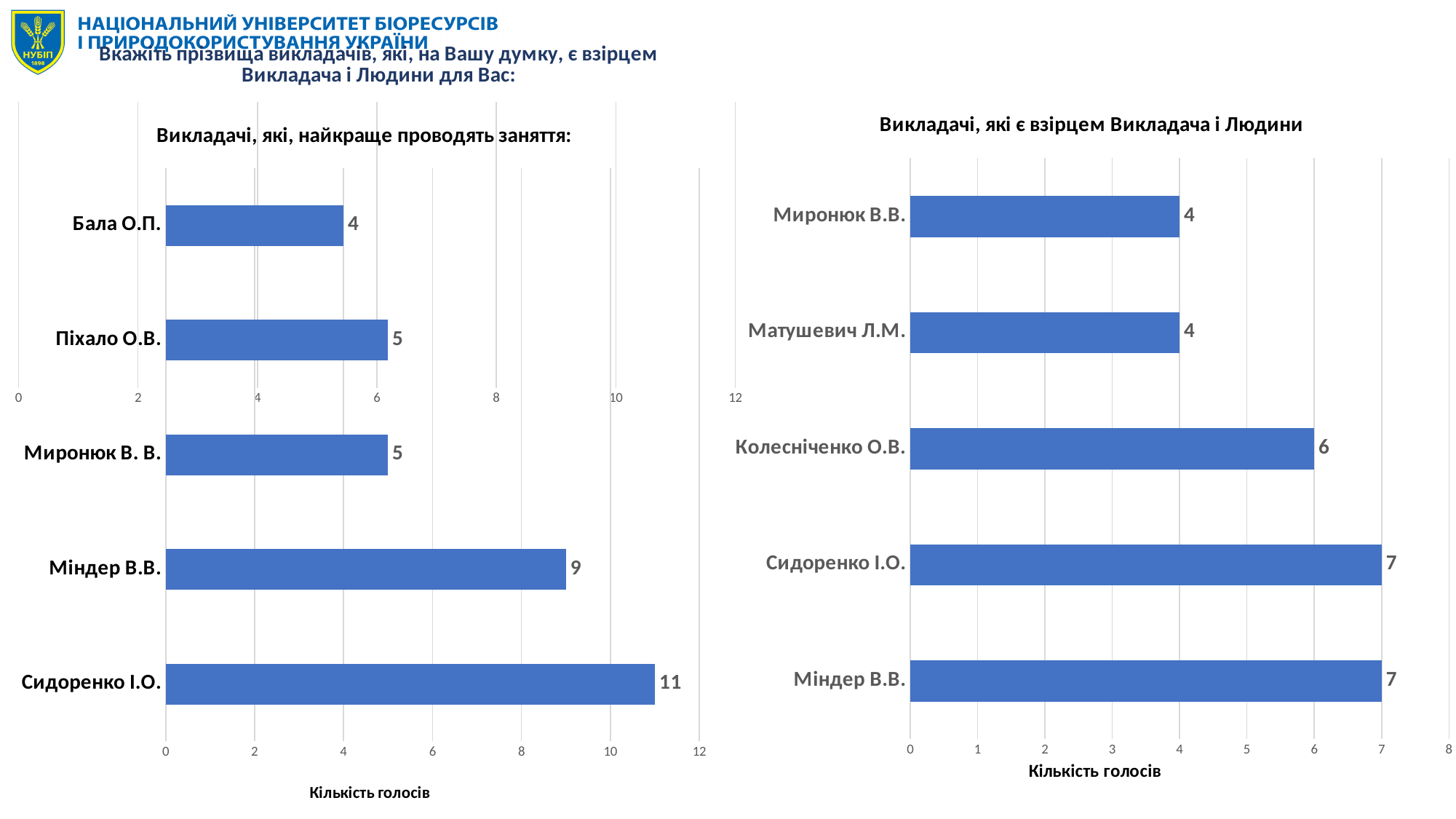
In the chart 'Викладачі, які, найкраще проводять заняття:', which teacher has the lowest number of votes? Бала О.П. In the chart 'Викладачі, які, найкраще проводять заняття:', how many teachers are listed? 5 In the chart 'Викладачі, які є взірцем Викладача і Людини', which has more votes, Колесніченко О.В. or Миронюк В.В.? Колесніченко О.В. In the chart 'Викладачі, які, найкраще проводять заняття:', which teacher has the highest number of votes? Сидоренко І.О. What type of chart is 'Викладачі, які є взірцем Викладача і Людини'? Bar chart In the chart 'Викладачі, які є взірцем Викладача і Людини', how many votes did Матушевич Л.М. receive? 4 What is the x-axis title of the chart 'Викладачі, які є взірцем Викладача і Людини'? Кількість голосів In the chart 'Викладачі, які є взірцем Викладача і Людини', what is the difference in votes between Сидоренко І.О. and Матушевич Л.М.? 3 In the chart 'Викладачі, які, найкраще проводять заняття:', what is the difference in votes between Сидоренко І.О. and Міндер В.В.? 2 In the chart 'Викладачі, які, найкраще проводять заняття:', how many votes did Міндер В.В. receive? 9 In the chart 'Викладачі, які є взірцем Викладача і Людини', how many votes did Колесніченко О.В. receive? 6 In the chart 'Викладачі, які, найкраще проводять заняття:', how many votes did Сидоренко І.О. receive? 11